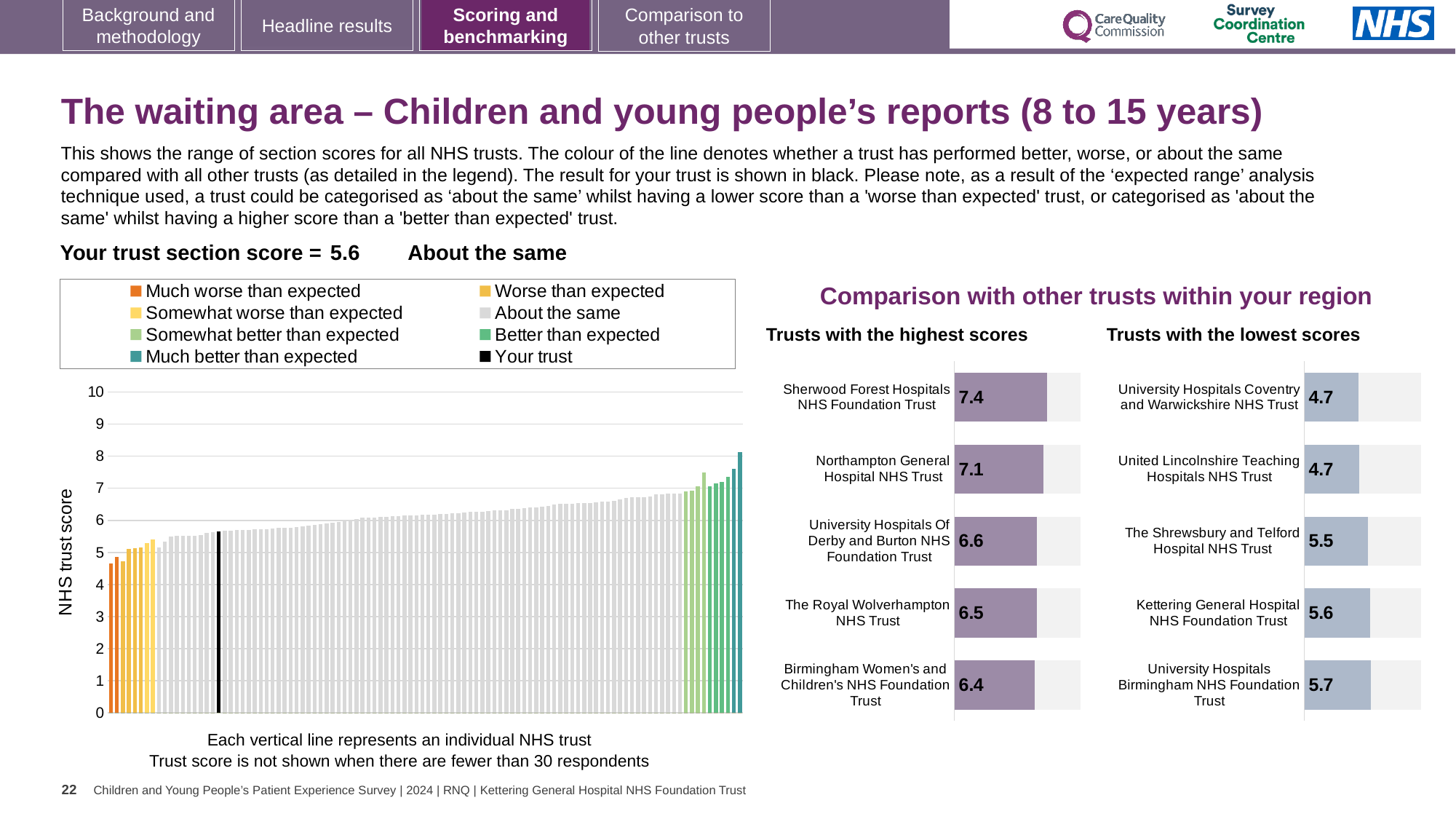
How many trusts are shown in the 'Trusts with the lowest scores' chart? 5 How many entries does the legend of the main 'NHS trust score' chart on the left list? 8 In the main 'NHS trust score' chart on the left, do the bar values rise or fall from left to right? rise In the 'Trusts with the lowest scores' chart, which has the larger score: The Shrewsbury and Telford Hospital NHS Trust or University Hospitals Birmingham NHS Foundation Trust? University Hospitals Birmingham NHS Foundation Trust In the main 'NHS trust score' chart on the left, is the value of the lowest bar greater or less than 5? less In the 'Trusts with the lowest scores' chart, what is the score for Kettering General Hospital NHS Foundation Trust? 5.6 In the 'Trusts with the lowest scores' chart, which trust has the highest score? University Hospitals Birmingham NHS Foundation Trust In the 'Trusts with the highest scores' chart, which trust has the lowest score? Birmingham Women's and Children's NHS Foundation Trust In the 'Trusts with the lowest scores' chart, what is the score for The Shrewsbury and Telford Hospital NHS Trust? 5.5 In the 'Trusts with the highest scores' chart, what is the difference between the scores of Sherwood Forest Hospitals NHS Foundation Trust and Northampton General Hospital NHS Trust? 0.3 In the 'Trusts with the highest scores' chart, what is the score for Sherwood Forest Hospitals NHS Foundation Trust? 7.4 In the 'Trusts with the highest scores' chart, what is the score for The Royal Wolverhampton NHS Trust? 6.5